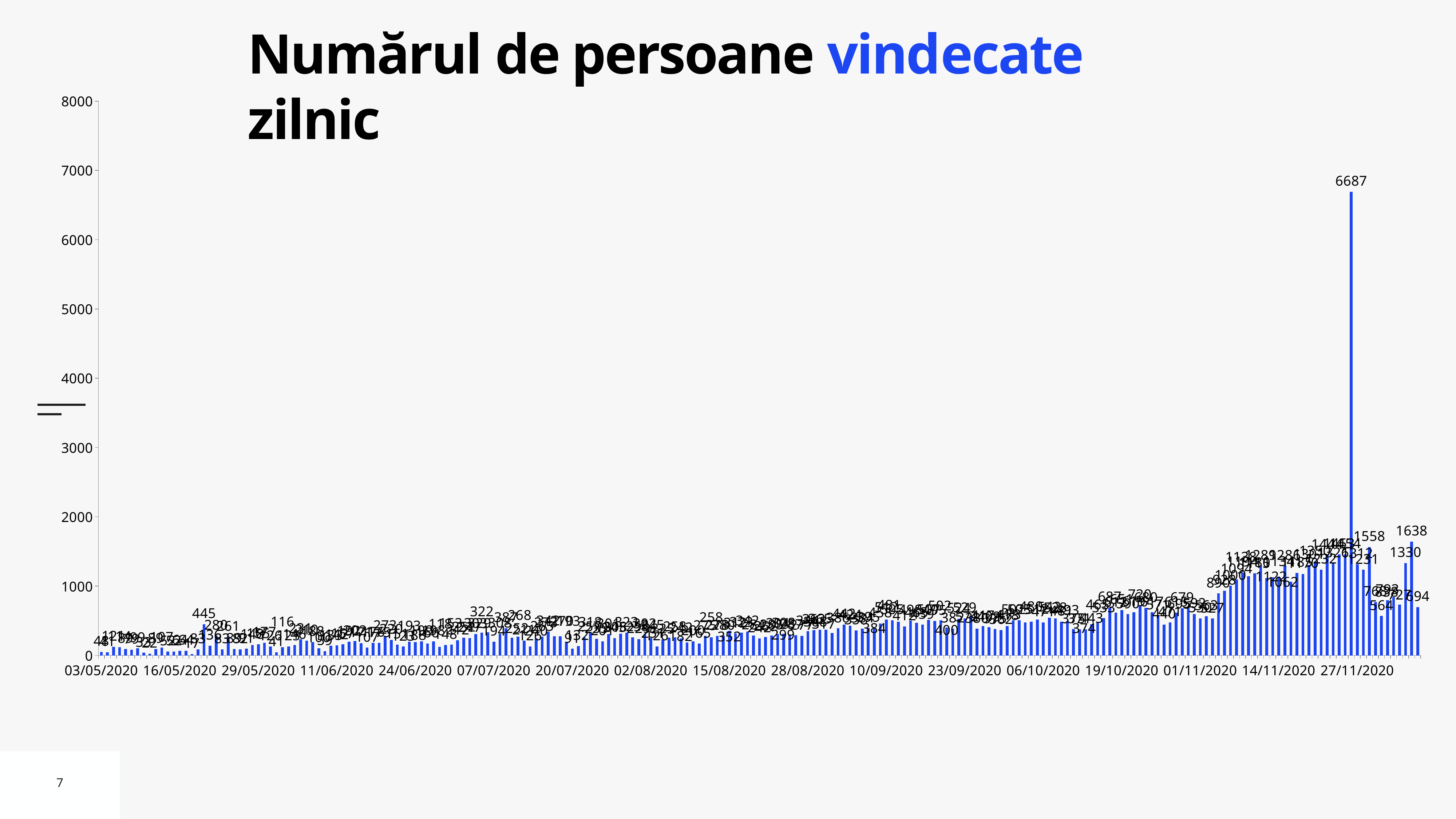
What is the title of the chart? Numărul de persoane vindecate zilnic Is the bar labelled 1330 greater or less than 2000? less What is the difference between the highest value (6687) and the value labelled 1638? 5049 How many date labels are shown on the horizontal axis? 17 What is the first date label on the horizontal axis? 03/05/2020 Which is larger, the bar labelled 1638 or the bar labelled 1558? 1638 Do the daily values generally rise or fall from May 2020 to November 2020? rise What is the last date label on the horizontal axis? 27/11/2020 What kind of chart is shown on the slide? bar chart Is the tallest bar greater or less than 6000? greater What is the highest value shown in the chart? 6687 What is the highest tick value on the vertical axis? 8000